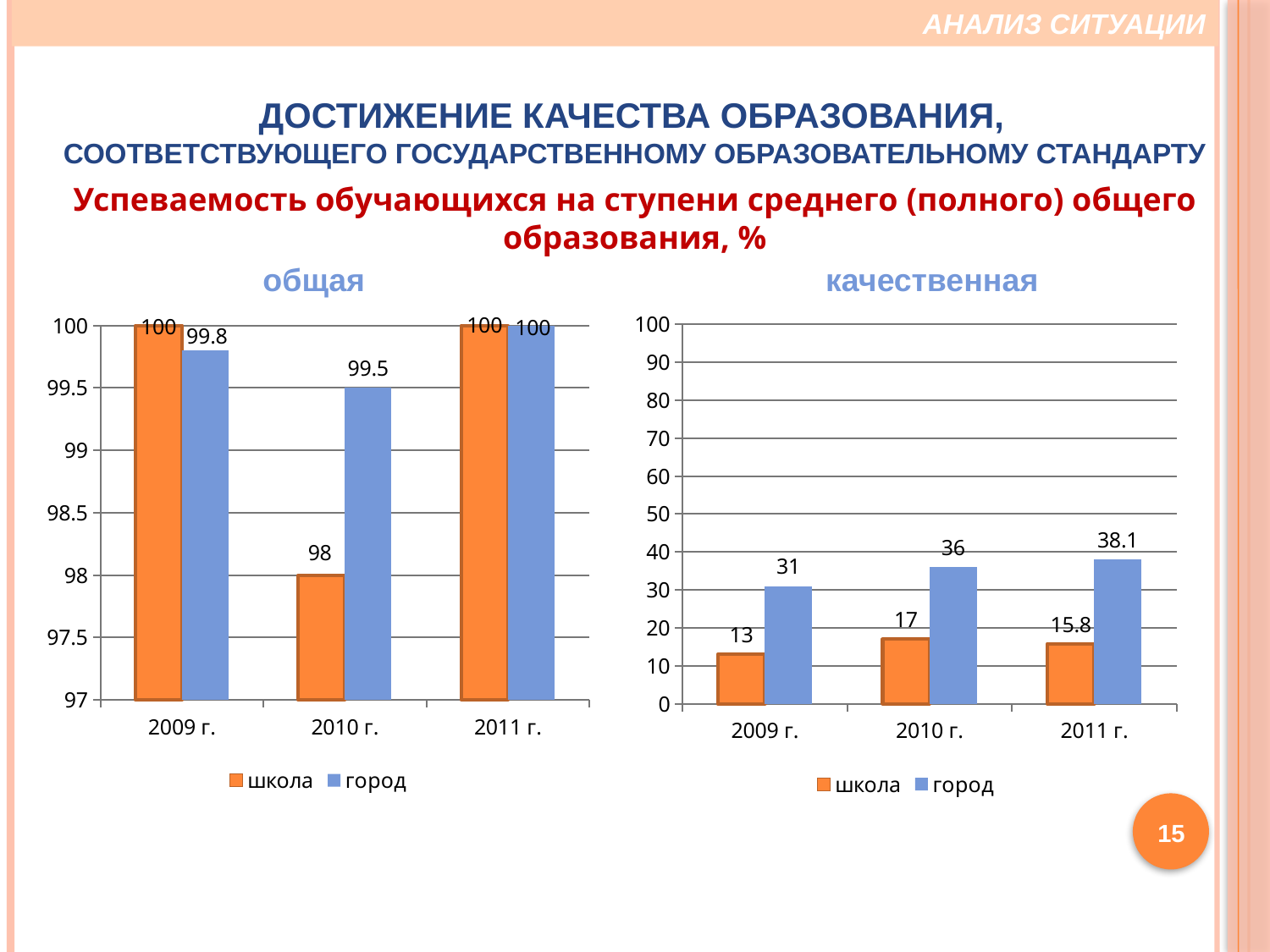
In the "общая" chart, what is the value for город in 2009 г.? 99.8 What kind of chart is the "качественная" chart? bar chart In the "качественная" chart, which is larger in 2010 г., школа or город? город In the "общая" chart, which year has the lowest value for школа? 2010 г. In the "качественная" chart, does the value for город rise or fall from 2009 г. to 2011 г.? rise In the "качественная" chart, what is the value for школа in 2009 г.? 13 In the "качественная" chart, what is the difference between город and школа in 2011 г.? 22.3 How many series does the legend of the "общая" chart list? 2 In the "качественная" chart, what is the value for город in 2011 г.? 38.1 In the "общая" chart, what is the difference between город and школа in 2010 г.? 1.5 In the "общая" chart, what is the value for школа in 2010 г.? 98 In the "качественная" chart, which year has the highest value for школа? 2010 г.